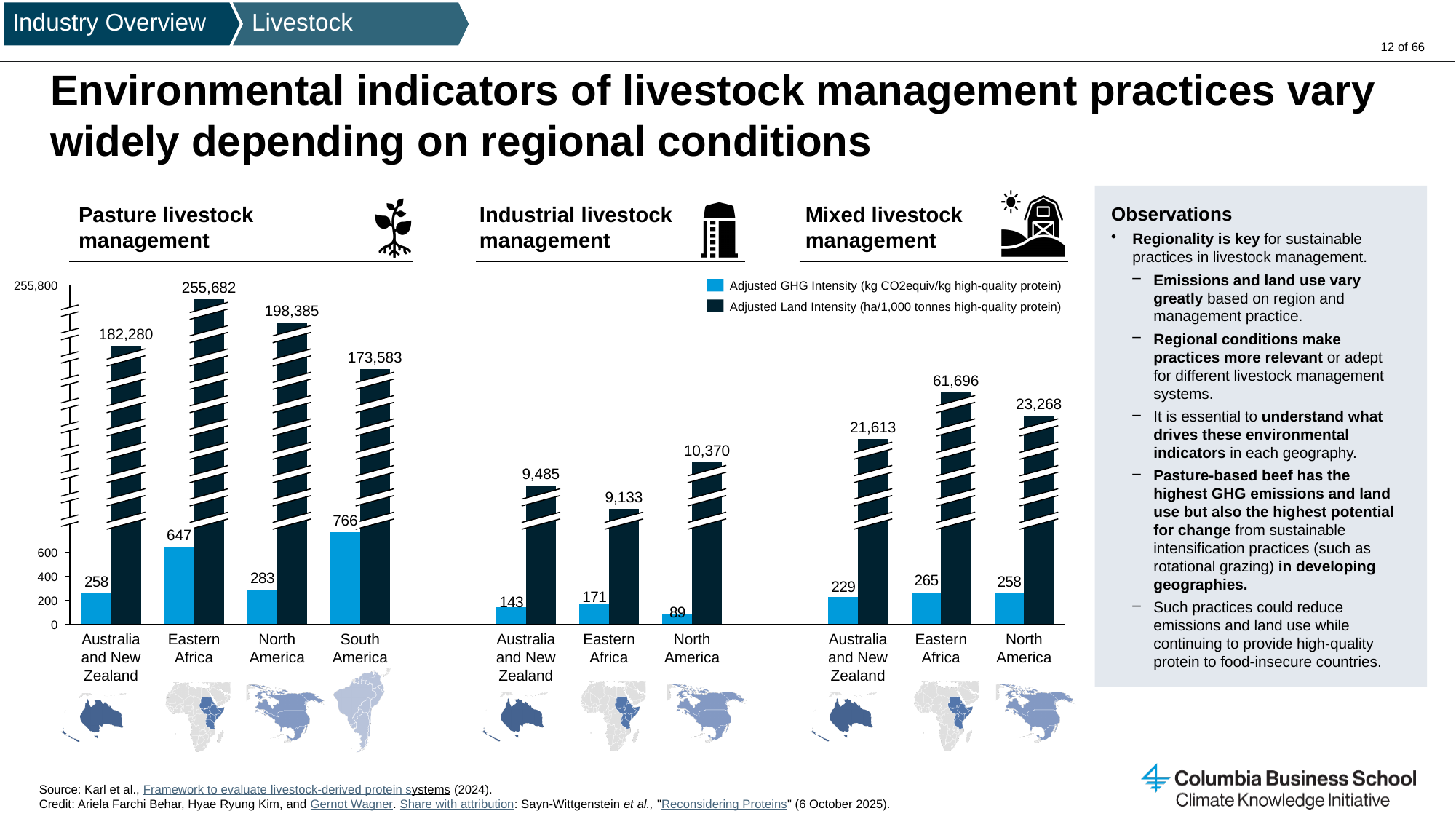
In the Mixed livestock management chart, what is the difference in Adjusted Land Intensity between Eastern Africa and North America? 38,428 In the Industrial livestock management chart, what is the Adjusted Land Intensity for North America? 10,370 In the Mixed livestock management chart, which region has the highest Adjusted Land Intensity? Eastern Africa In the Pasture livestock management chart, which region has the highest Adjusted Land Intensity? Eastern Africa In the Pasture livestock management chart, what is the Adjusted Land Intensity for Eastern Africa? 255,682 In the Mixed livestock management chart, what is the Adjusted GHG Intensity for Australia and New Zealand? 229 In the Pasture livestock management chart, what is the difference in Adjusted GHG Intensity between South America and Australia and New Zealand? 508 In the Industrial livestock management chart, which region has the lowest Adjusted GHG Intensity? North America In the Pasture livestock management chart, what is the Adjusted GHG Intensity for South America? 766 How many regions are shown in the Pasture livestock management chart? 4 In the Industrial livestock management chart, which has the larger Adjusted Land Intensity, Australia and New Zealand or Eastern Africa? Australia and New Zealand How many series does the legend list for the charts on this slide? 2